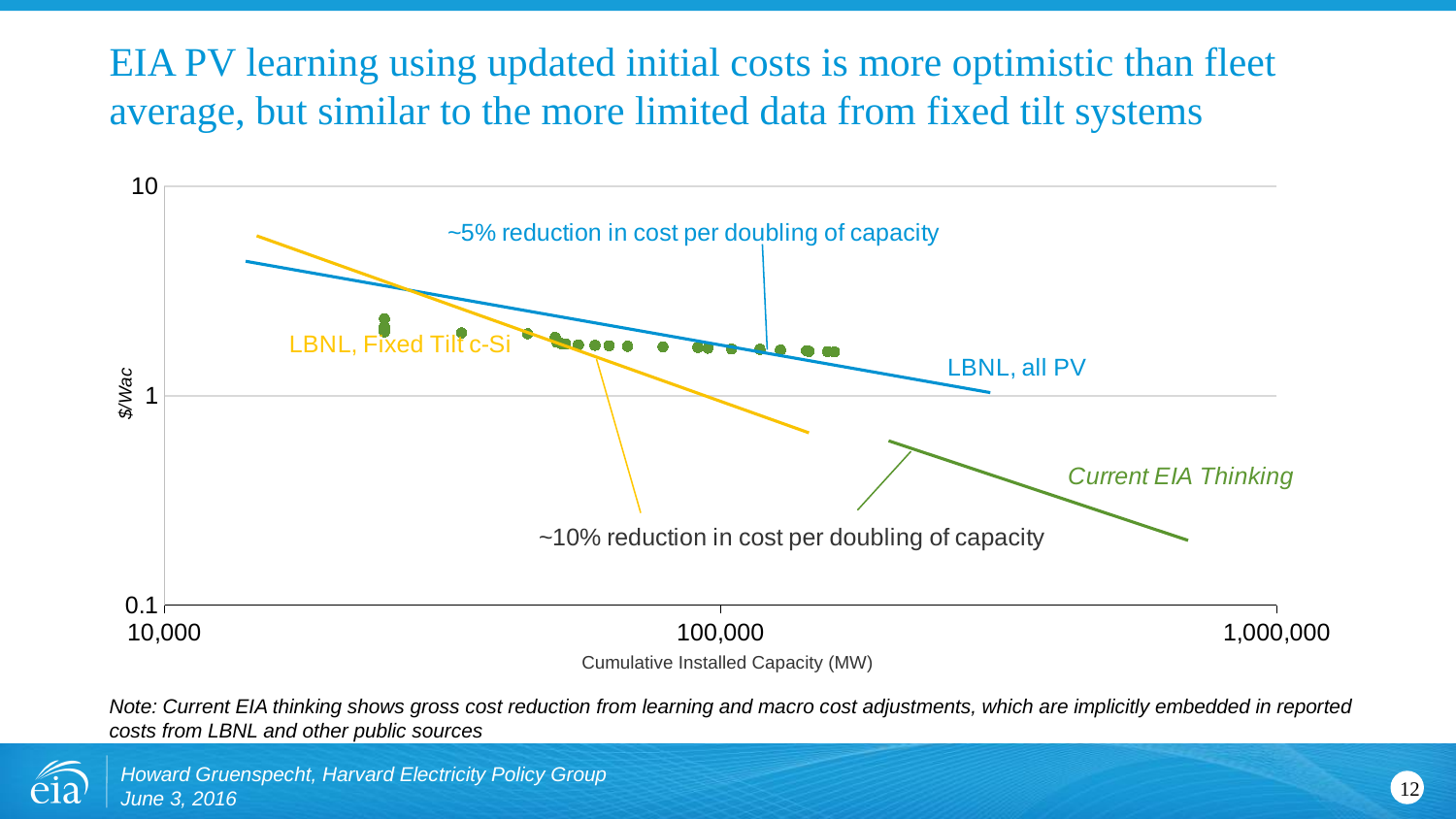
Is the LBNL, all PV line greater or less than 1 $/Wac at 100,000 MW? greater What is the largest value shown on the x axis? 1,000,000 How many labeled lines (series) are drawn on the chart? 3 What is the label of the y axis? $/Wac Which line is labeled with a ~5% reduction in cost per doubling of capacity? LBNL, all PV Which line is labeled with a ~10% reduction in cost per doubling of capacity? LBNL, Fixed Tilt c-Si What is the highest value shown on the y axis? 10 What kind of chart is shown on the slide? Line chart (on logarithmic axes) Which line lies lowest on the chart: LBNL, all PV or Current EIA Thinking? Current EIA Thinking Is the Current EIA Thinking line greater or less than 1 $/Wac across its whole range? less What is the label of the x axis? Cumulative Installed Capacity (MW) Do the plotted lines rise or fall as cumulative installed capacity increases? Fall